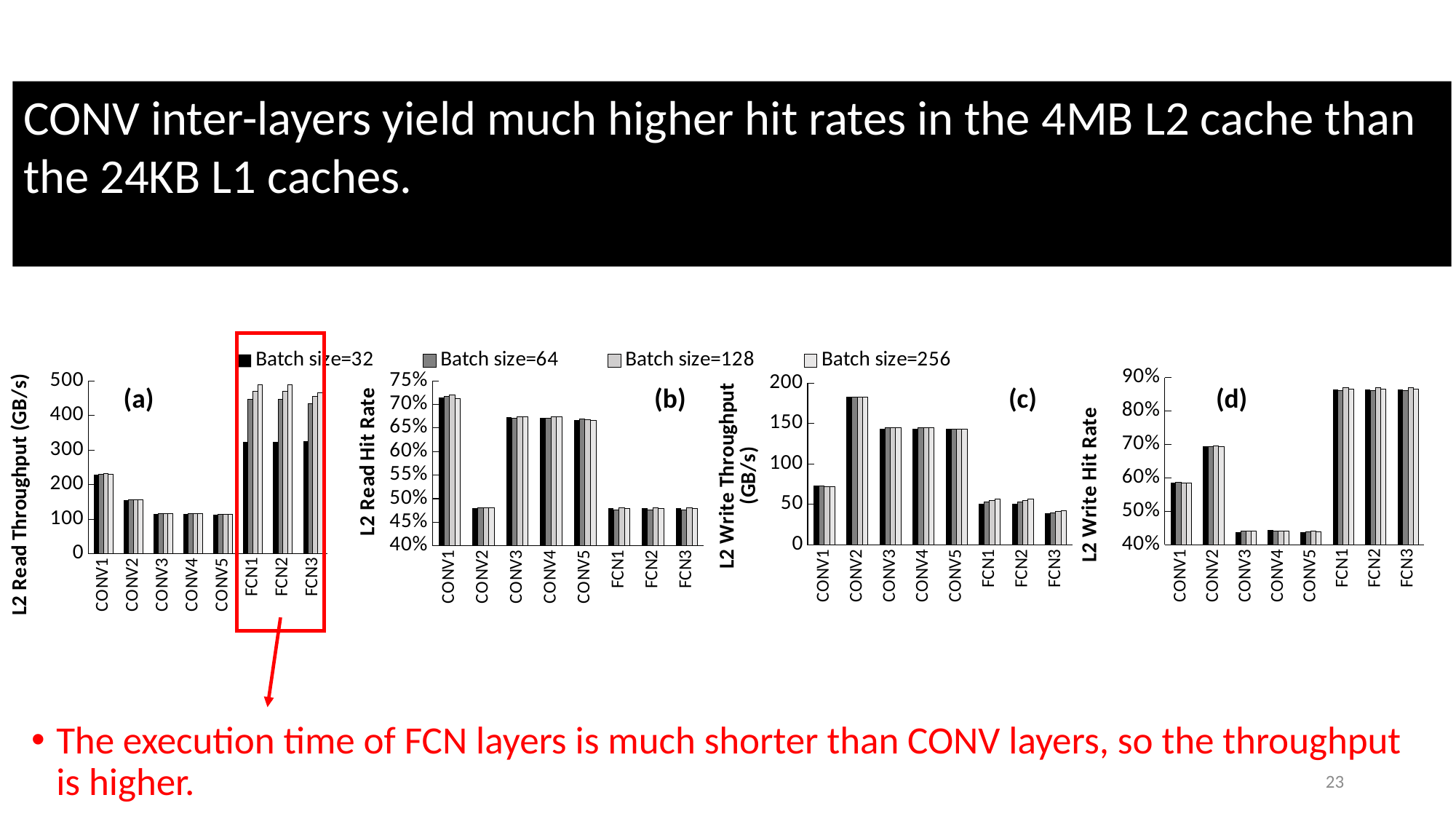
In chart (c), L2 Write Throughput, is the value for CONV2 at batch size 64 greater or less than 150? greater In chart (b), L2 Read Hit Rate, is the value for CONV2 at batch size 32 greater or less than 50%? less In chart (a), L2 Read Throughput, is the value for CONV1 at batch size 32 greater or less than 200? greater How many categories are shown on the x axis of chart (c), L2 Write Throughput? 8 In chart (c), L2 Write Throughput, which category has the lowest throughput? FCN3 What kind of chart is chart (a), L2 Read Throughput? bar chart In chart (b), L2 Read Hit Rate, which category has the highest hit rate? CONV1 How many series does the shared legend above the charts list? 4 In chart (d), L2 Write Hit Rate, which is larger at batch size 32: CONV1 or CONV2? CONV2 In chart (c), L2 Write Throughput, which category has the highest throughput? CONV2